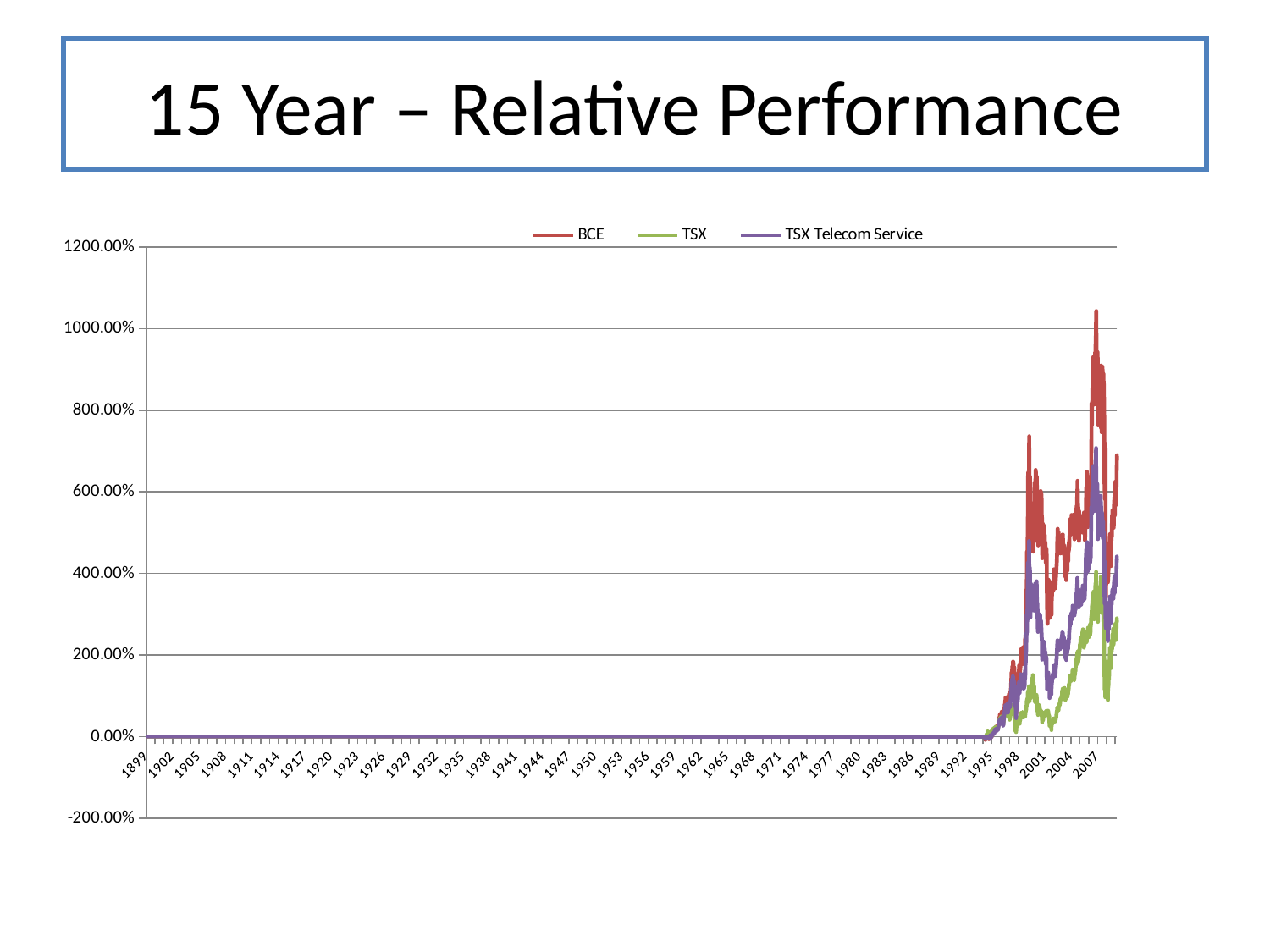
Which series reaches the highest peak value on the chart? BCE Do the series values rise, fall, or stay flat between 1899 and the early 1990s? Stay flat at 0.00% Is the peak value of the BCE series greater or less than 800%? greater How many series does the legend list? 3 Which series has the lowest peak value on the chart? TSX What kind of chart is shown on the slide? Line chart What colour is the BCE line? Red Is the peak value of the TSX Telecom Service series greater or less than 800%? less Which series peaks higher, BCE or TSX? BCE Which series peaks higher, TSX Telecom Service or TSX? TSX Telecom Service Is the peak value of the TSX series greater or less than 600%? less What are the three series named in the legend? BCE, TSX, TSX Telecom Service